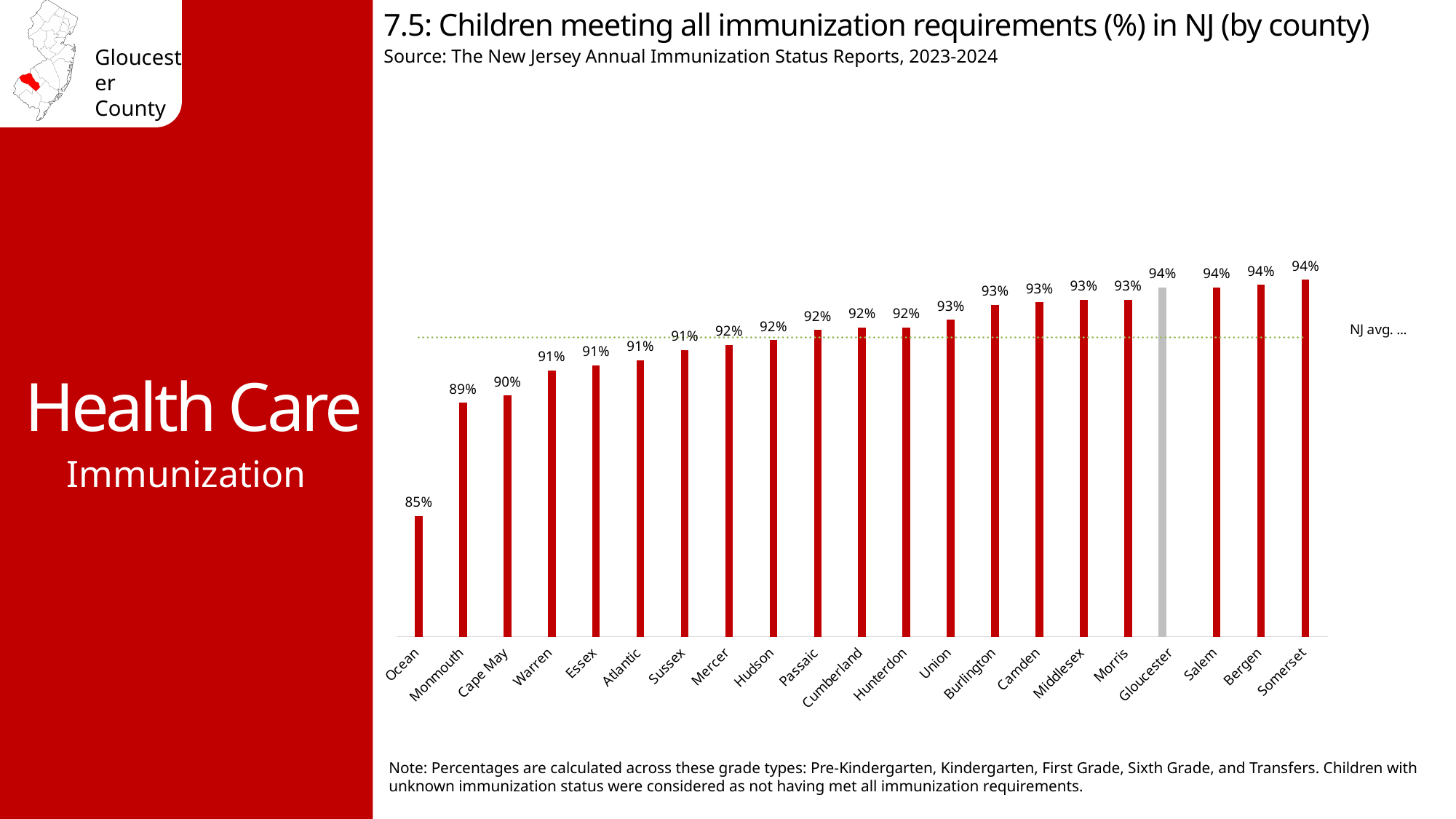
Which county's bar is coloured grey instead of red? Gloucester How many counties are shown on the chart? 21 What is the value for Cape May? 90% What percentage is shown for Hudson County? 92% What is the difference in percentage points between Gloucester County and Ocean County? 9 percentage points Do the values generally rise or fall from left to right across the counties? Rise What percentage is shown for Monmouth County? 89% What percentage of children in Gloucester County met all immunization requirements? 94% What is the value shown for Ocean County? 85% What kind of chart is shown on the slide? Bar chart Which county has the lowest percentage of children meeting all immunization requirements? Ocean Which has a higher value, Monmouth or Morris? Morris